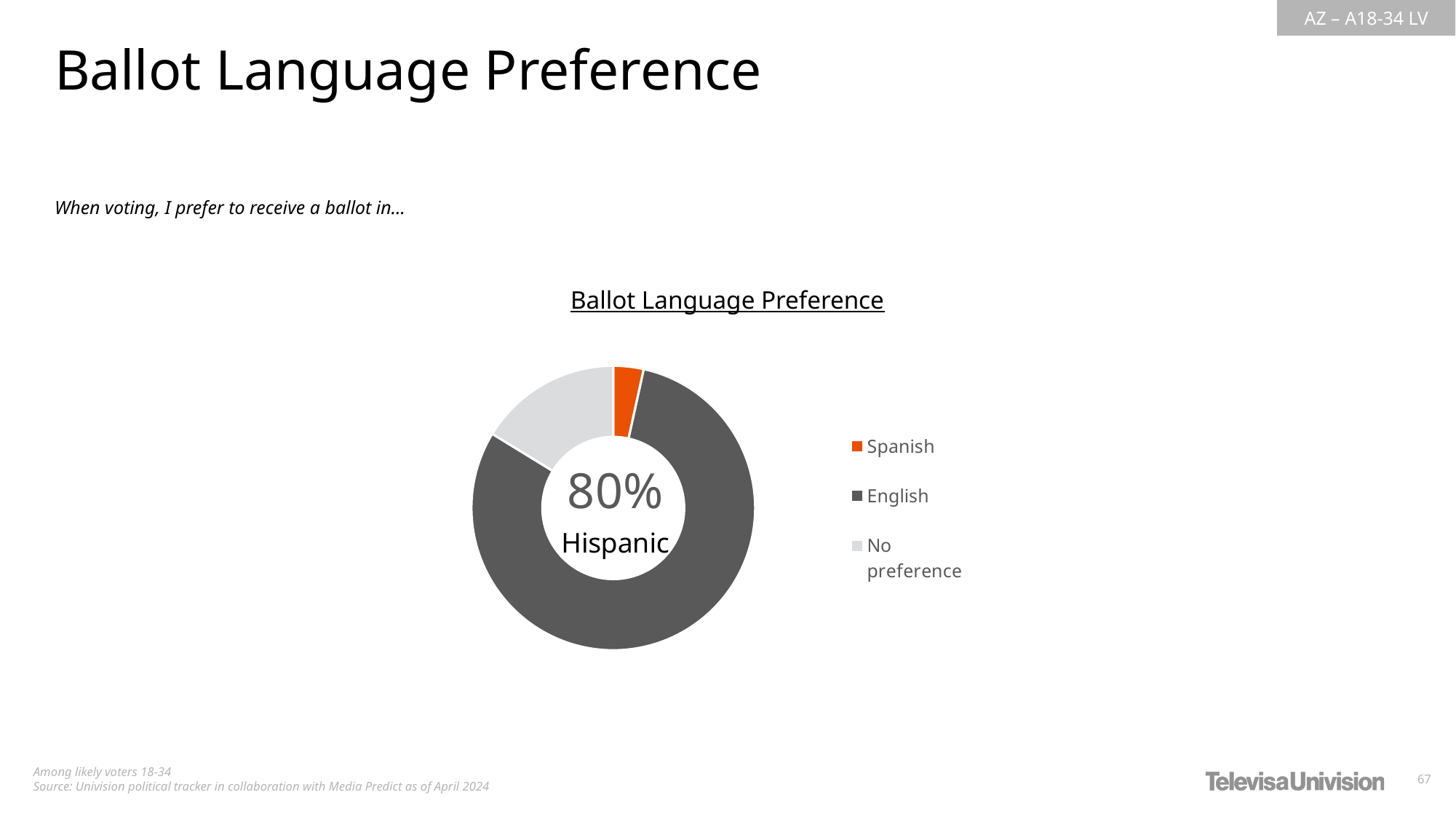
How many categories does the Ballot Language Preference chart show? 3 What kind of chart is shown on the slide? doughnut chart Which category has the largest slice in the Ballot Language Preference chart? English How many entries does the legend of the chart list? 3 What is the title of the chart? Ballot Language Preference What colour represents Spanish in the chart? orange Which slice is larger, No preference or Spanish? No preference Which category has the smallest slice in the Ballot Language Preference chart? Spanish Which slice is larger, English or No preference? English